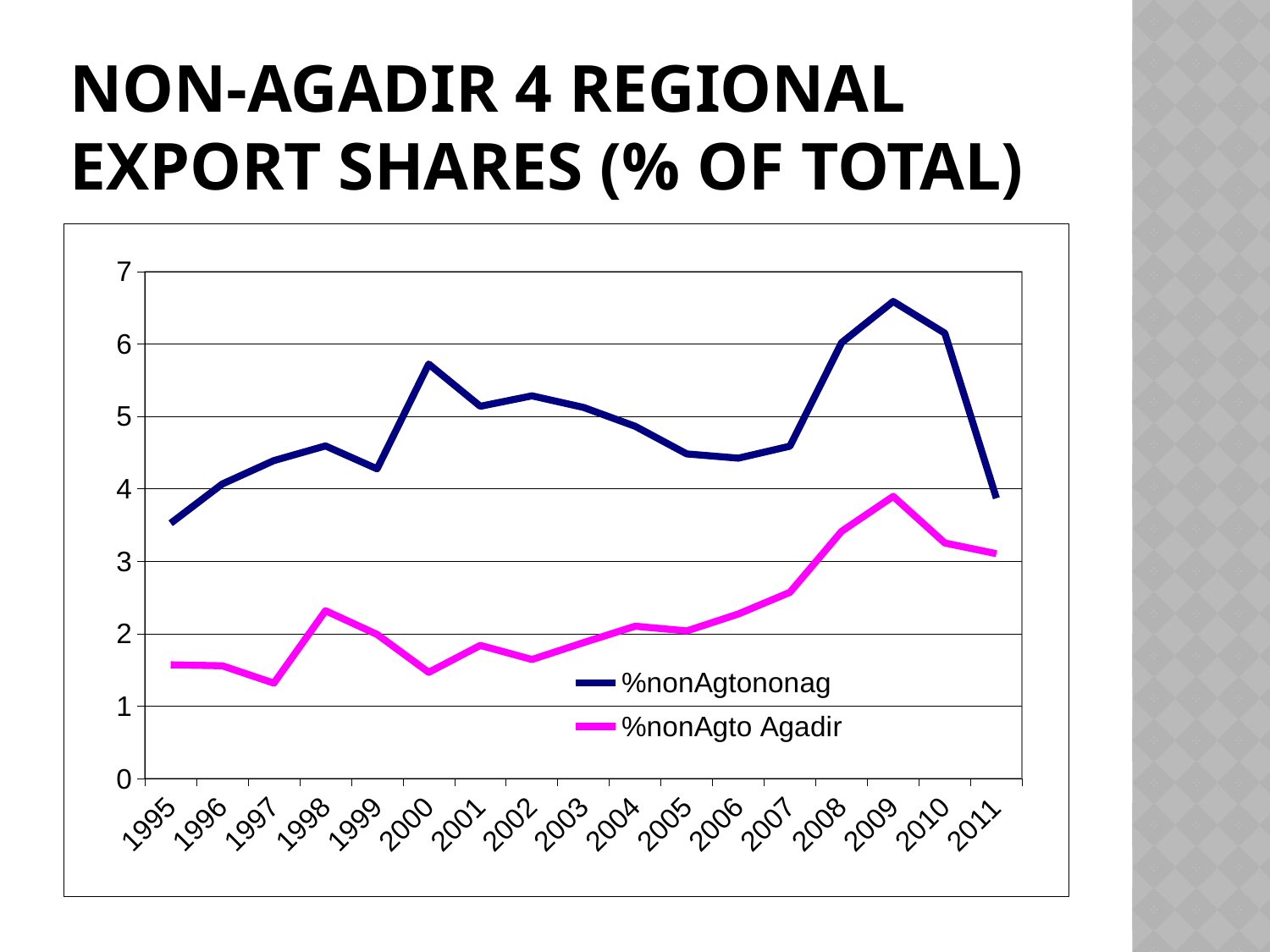
Is the value for %nonAgtononag in 2009 greater or less than 6? greater Does the %nonAgto Agadir series rise or fall from 2005 to 2009? rise Is the value for %nonAgto Agadir in 2008 greater or less than 3? greater In which year does the %nonAgtononag series reach its highest value? 2009 What kind of chart is shown on the slide? line chart How many years are plotted along the x axis? 17 In which year does the %nonAgto Agadir series reach its highest value? 2009 Which series has the larger value in 2009, %nonAgtononag or %nonAgto Agadir? %nonAgtononag How many series does the legend list? 2 Is the value for %nonAgtononag in 1995 greater or less than 4? less In which year is the %nonAgtononag series at its lowest value? 1995